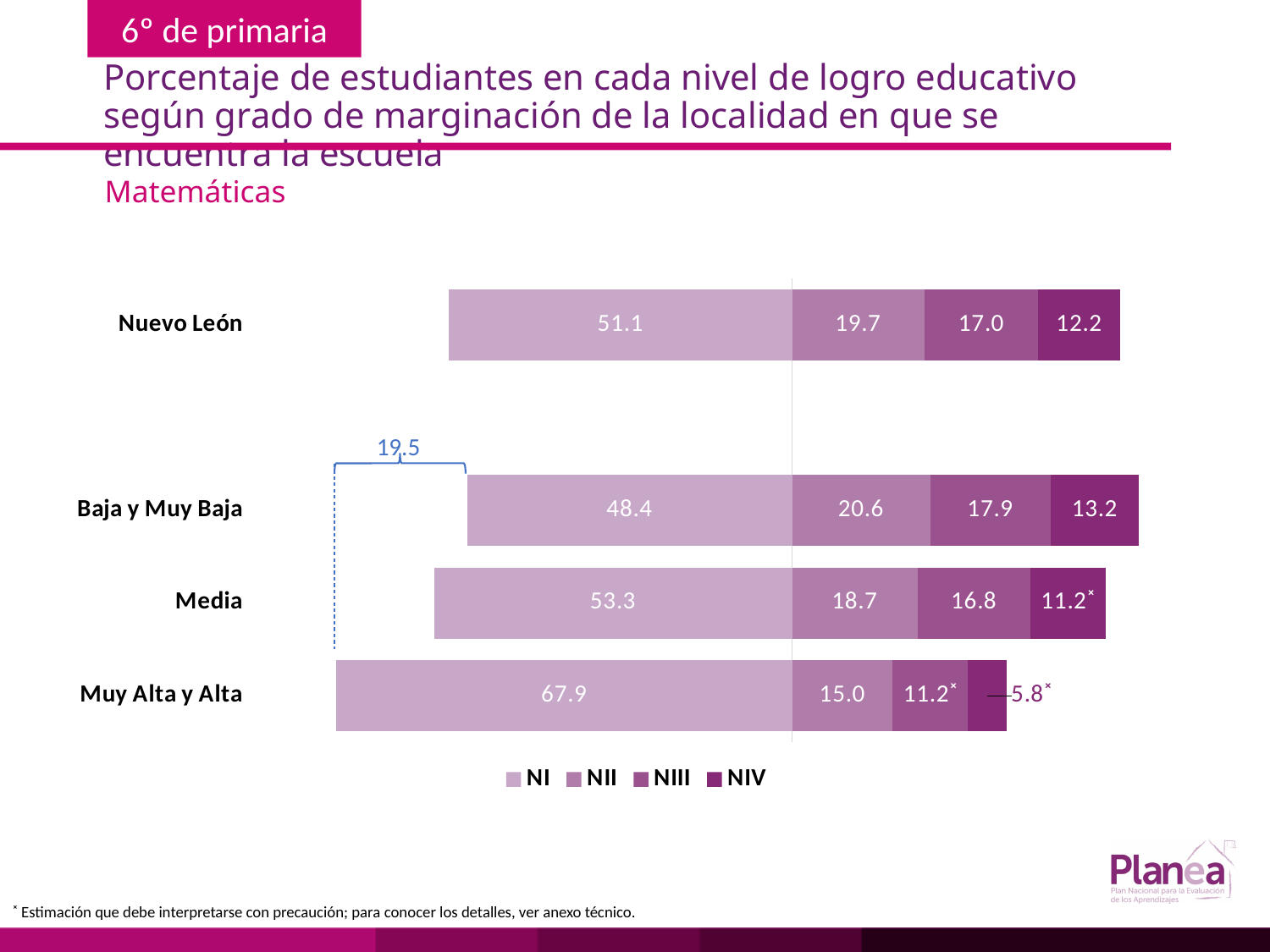
What are the legend entries of the chart? NI, NII, NIII, NIV What kind of chart is shown on the slide? Stacked bar chart What is the NII value for Baja y Muy Baja? 20.6 Which category has the lowest NIV value? Muy Alta y Alta How many categories are shown on the chart? 4 What is the NI value for Muy Alta y Alta? 67.9 Which category has the highest NI value? Muy Alta y Alta What is the difference between the NI values for Muy Alta y Alta and Baja y Muy Baja? 19.5 How many series does the legend list? 4 What is the NIII value for Media? 16.8 Which has a larger NII value, Nuevo León or Media? Nuevo León What is the NIV value for Nuevo León? 12.2